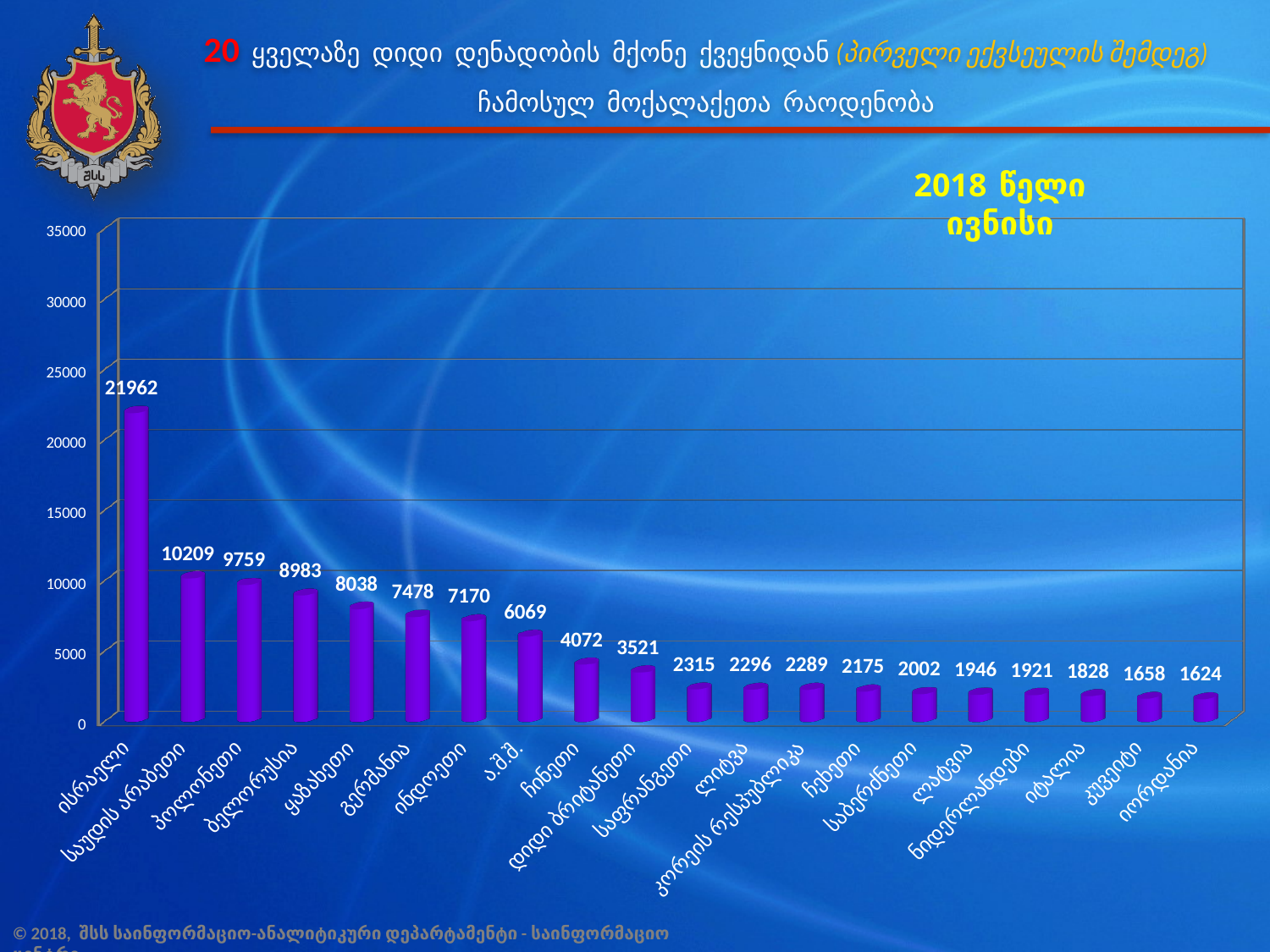
What is the value for ჩინეთი (China)? 4072 What is the difference between the values for საუდის არაბეთი (Saudi Arabia) and პოლონეთი (Poland)? 450 Which category has the highest value? ისრაელი What period is indicated in the yellow text above the chart? 2018 წელი ივნისი How many categories are shown on the chart? 20 What is the value for ისრაელი (Israel)? 21962 Is the value for ბელორუსია (Belarus) greater or less than 10000? less Which category has the lowest value? იორდანია Which is larger, the value for ინდოეთი (India) or the value for ა.შ.შ. (USA)? ინდოეთი What kind of chart is shown on the slide? bar chart What is the value for გერმანია (Germany)? 7478 Do the values rise or fall from left to right along the x axis? fall